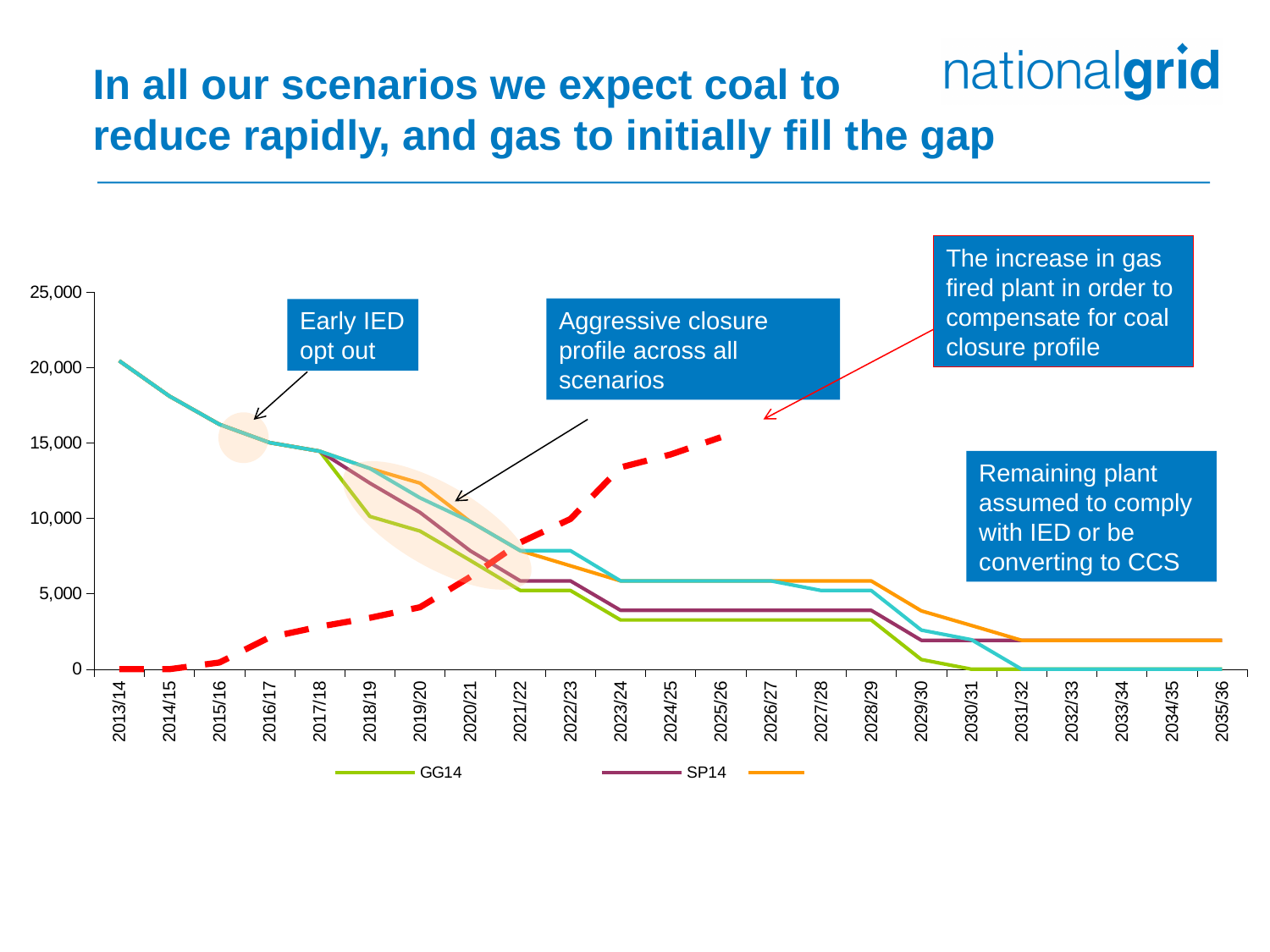
Is the value of the red dashed line for 2025/26 greater or less than 10,000? greater How many years are shown along the x axis of the chart? 23 Is the GG14 value for 2023/24 greater or less than 5,000? less What is the highest value shown on the y axis? 25,000 In which year is the GG14 value highest? 2013/14 Does the GG14 line rise or fall from 2013/14 to 2035/36? fall Is the value of the red dashed line for 2017/18 greater or less than 5,000? less Does the red dashed line rise or fall from 2013/14 to 2025/26? rise What is the first year shown on the x axis? 2013/14 What kind of chart is shown on the slide? line chart In 2018/19, which is larger, the GG14 value or the SP14 value? SP14